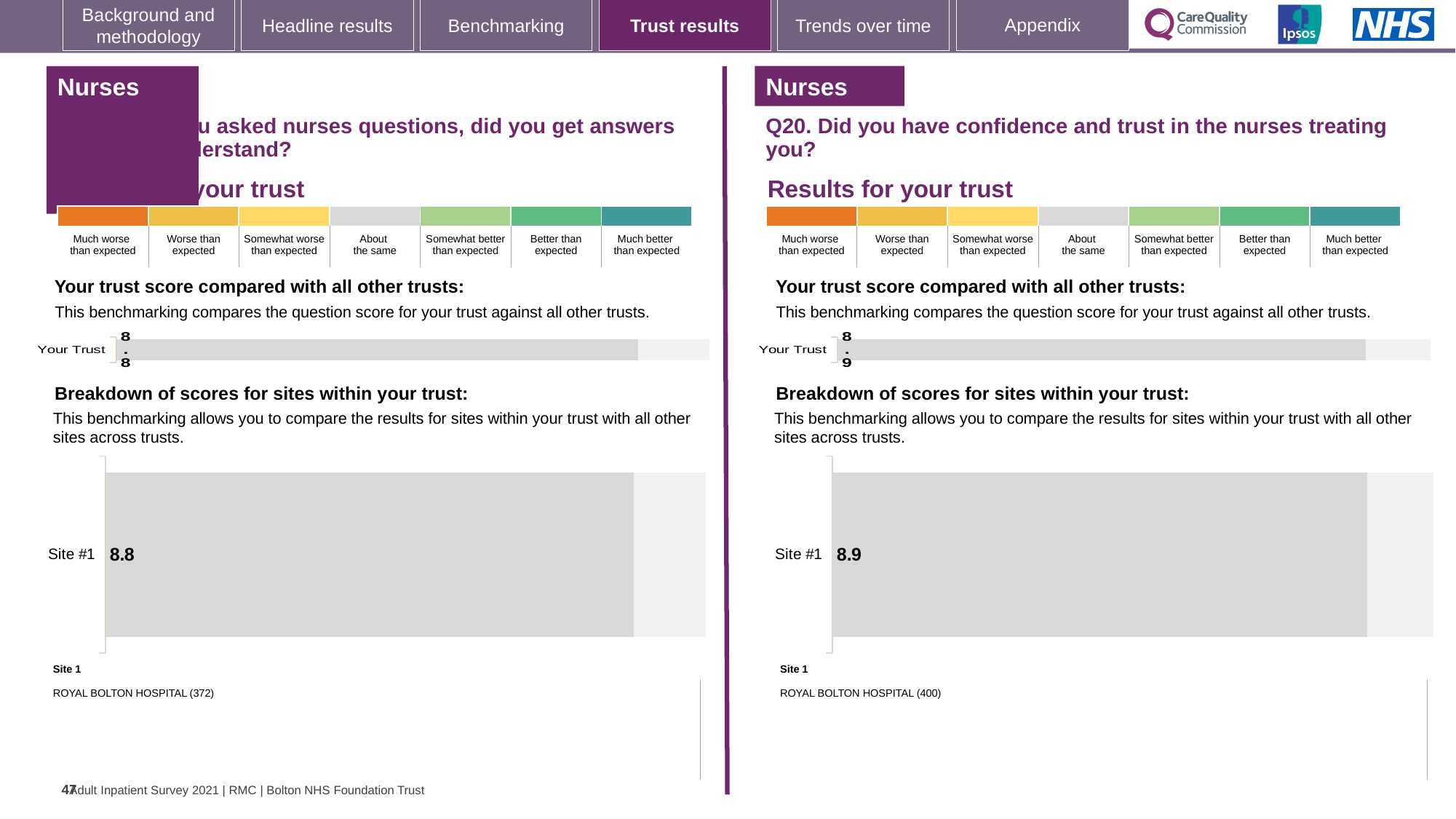
On the left half of the slide, what is the value shown for Your Trust in the trust score comparison chart? 8.8 What is the name of Site 1 listed below the breakdown chart on the right half of the slide (Q20)? ROYAL BOLTON HOSPITAL (400) What is the difference between the Site #1 score on the right half of the slide (Q20) and the Site #1 score on the left half? 0.1 On the left half of the slide, what is the score shown for Site #1 in the breakdown of scores for sites within your trust? 8.8 How many sites are shown in the breakdown of scores chart on the right half of the slide (Q20)? 1 Which Site #1 score is larger: the one on the left half of the slide or the one on the right half (Q20)? Right half (Q20), 8.9 On the right half of the slide (Q20), what is the value shown for Your Trust in the trust score comparison chart? 8.9 On the right half of the slide (Q20), what is the score shown for Site #1 in the breakdown of scores for sites within your trust? 8.9 How many sites are shown in the breakdown of scores chart on the left half of the slide? 1 What kind of chart is used for the breakdown of scores for sites within your trust on the right half of the slide (Q20)? Bar chart What is the name of Site 1 listed below the breakdown chart on the left half of the slide? ROYAL BOLTON HOSPITAL (372)